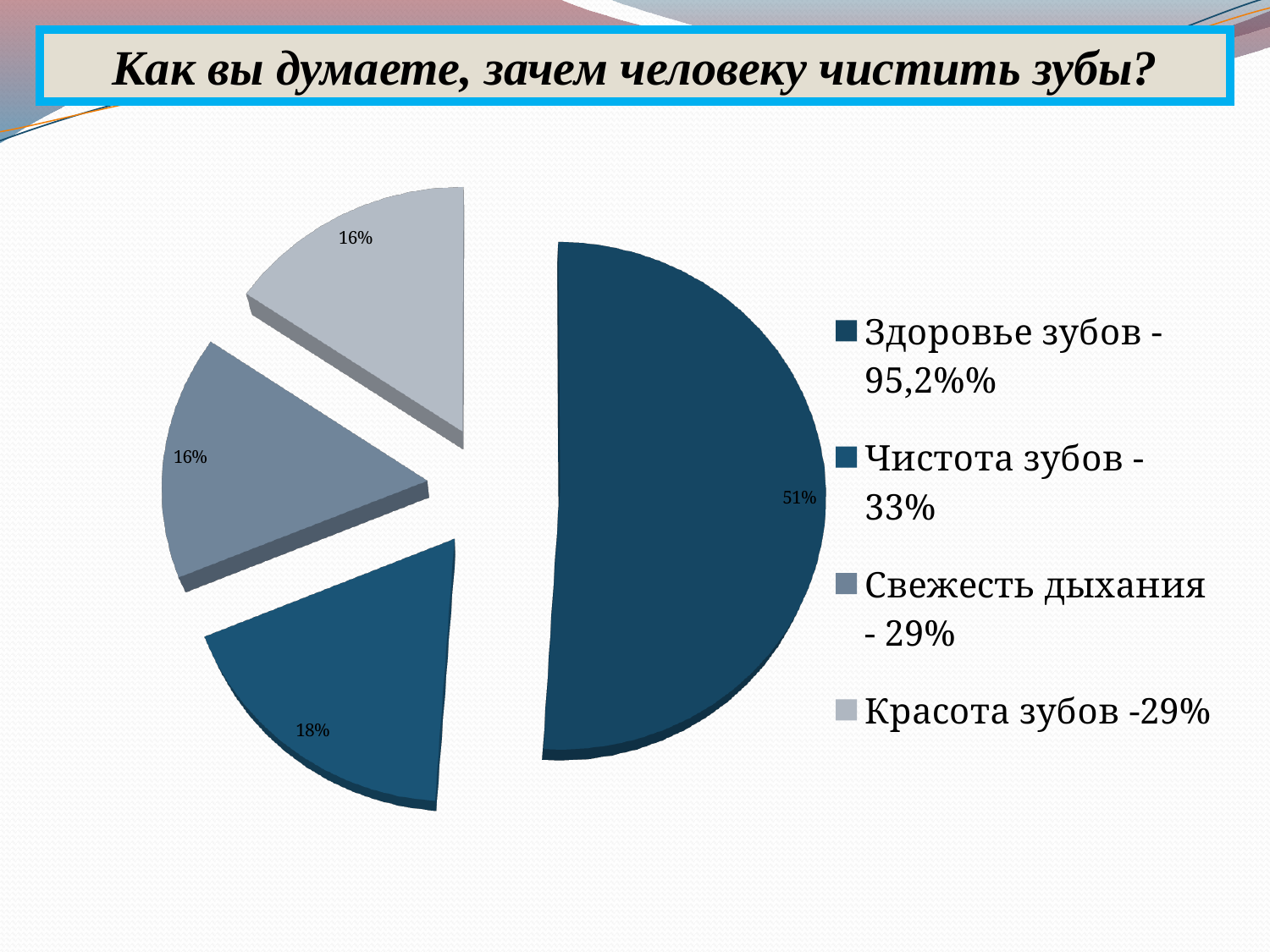
What percentage is shown on the slice for Свежесть дыхания? 16% What is the title of the slide containing the pie chart? Как вы думаете, зачем человеку чистить зубы? What is the difference in percentage points between the Здоровье зубов slice and the Чистота зубов slice? 33 How many entries does the legend of the pie chart list? 4 What percentage is shown on the slice for Чистота зубов? 18% Is the value for Здоровье зубов greater or less than 50%? greater What percentage is shown on the slice for Красота зубов? 16% How many slices does the pie chart have? 4 Which category has the largest slice of the pie chart? Здоровье зубов What percentage is shown on the slice for Здоровье зубов? 51% Which slice is larger: Чистота зубов or Свежесть дыхания? Чистота зубов What kind of chart is shown on the slide? Pie chart